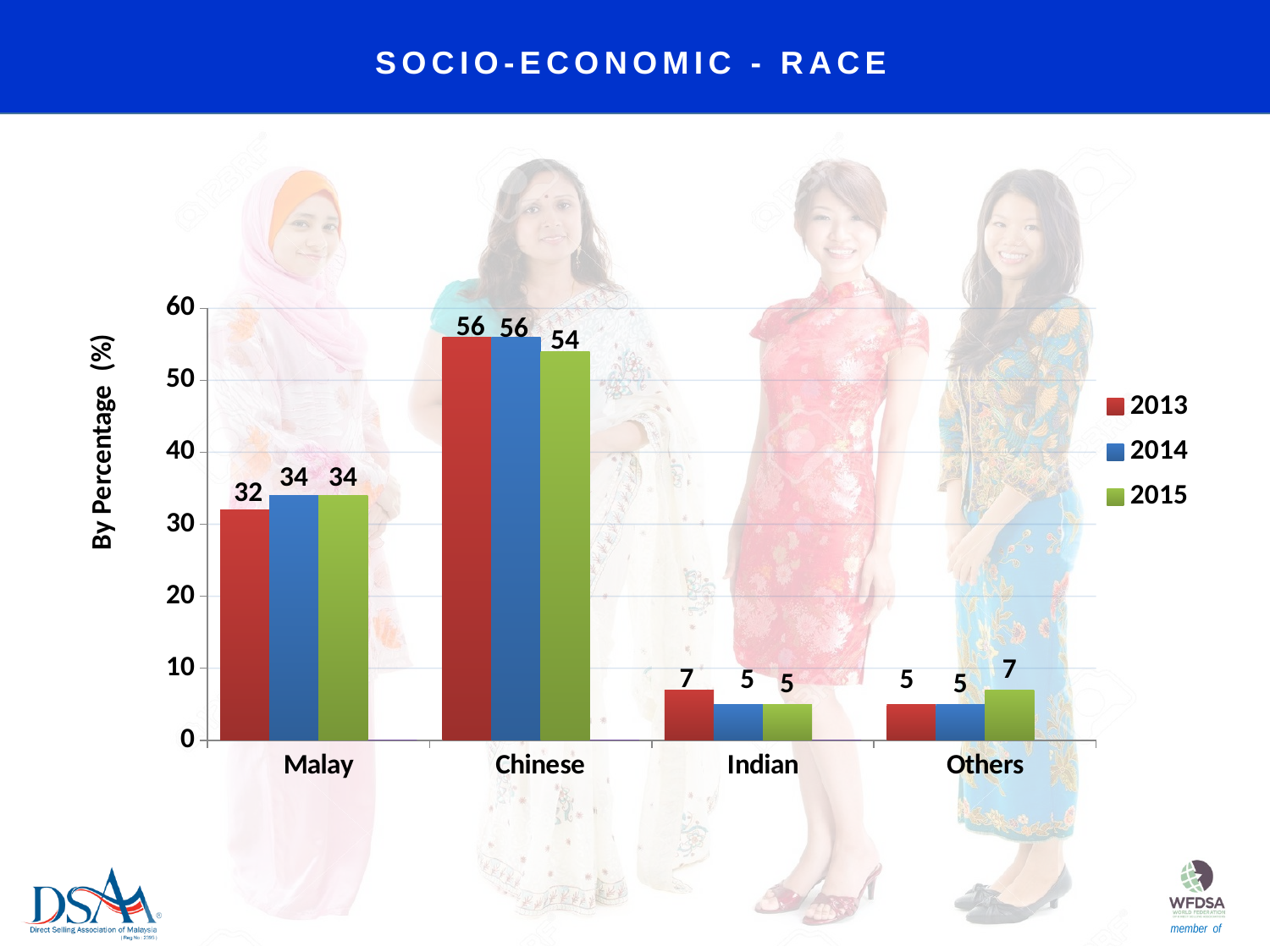
What is the value for Chinese in 2015? 54 What is the label of the vertical axis? By Percentage (%) Which is larger, the 2013 value for Indian or the 2013 value for Others? Indian Which race category has the highest value in 2014? Chinese What kind of chart is shown on the slide? Bar chart What is the value for Malay in 2013? 32 How many race categories are shown on the x axis? 4 What is the value for Indian in 2013? 7 Which race category has the lowest value in 2015? Indian What is the value for Others in 2015? 7 What is the difference between the Chinese and Malay values in 2015? 20 How many series does the legend list? 3